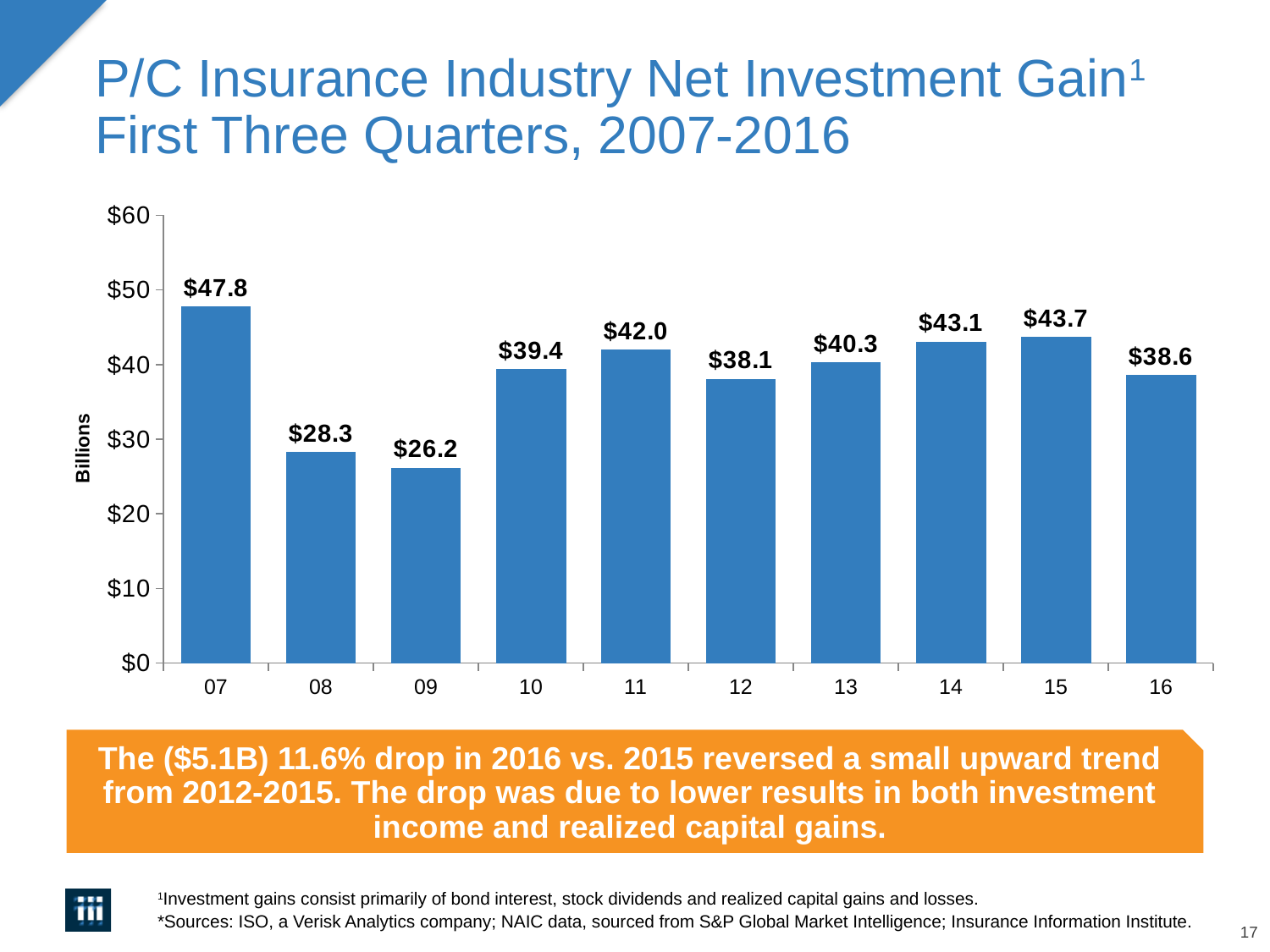
What is the difference between the 2015 and 2016 values? $5.1 Do the values rise or fall from 2012 to 2015? rise Is the value for 2008 greater or less than $30? less What is the value shown for 2009 (labelled 09)? $26.2 What kind of chart is shown on the slide? bar chart Which year has the lowest net investment gain? 09 What is the label on the vertical axis? Billions Which is larger, the value for 2010 or the value for 2012? 2010 What is the net investment gain for 2007 (labelled 07)? $47.8 How many years are shown on the x axis? 10 What is the value shown for 2015 (labelled 15)? $43.7 Which year has the highest net investment gain? 07